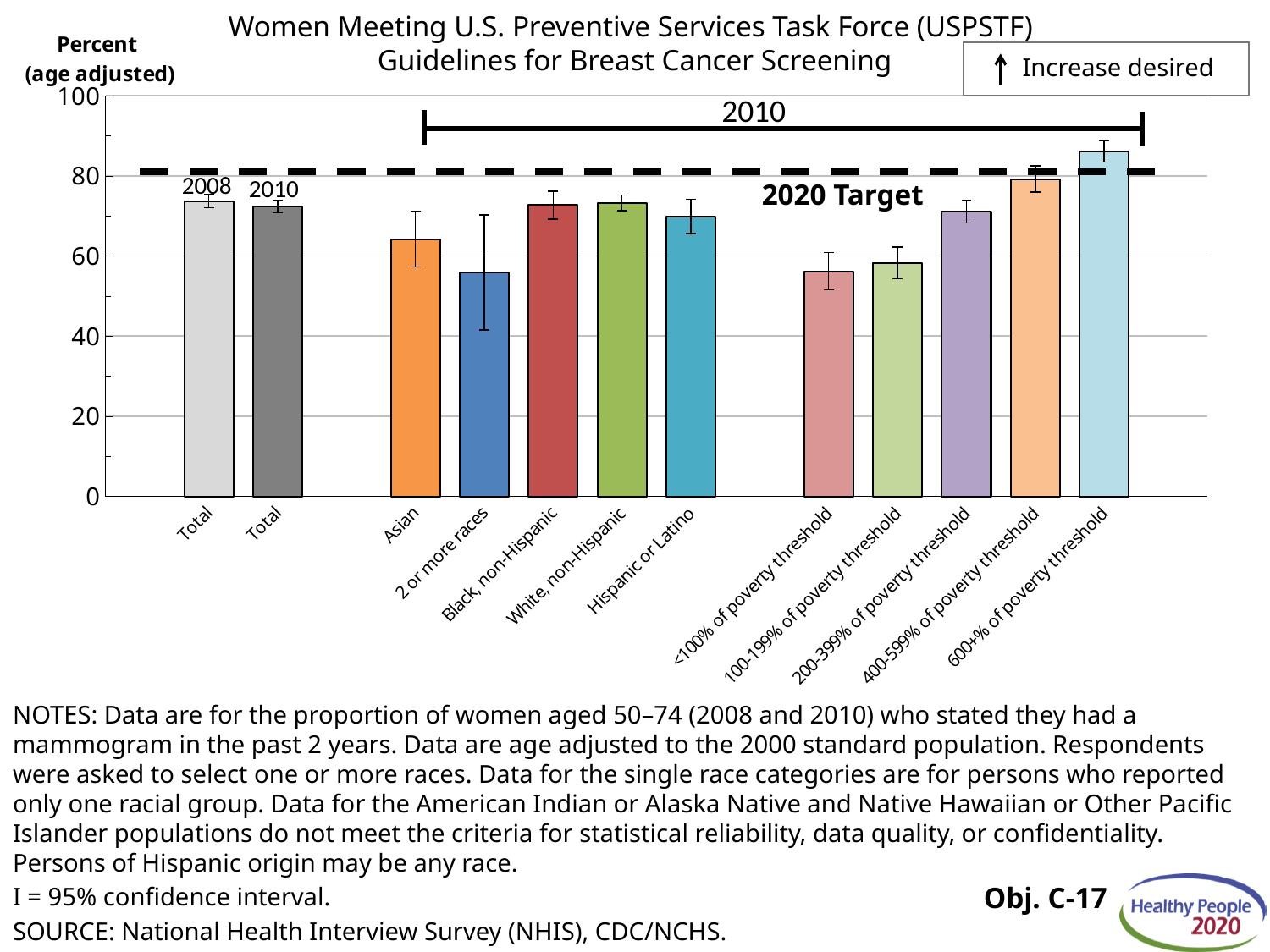
Is the value for 600+% of poverty threshold greater or less than 80? greater Is the value for Asian greater or less than 60? greater Which is larger, the value for 400-599% of poverty threshold or the value for 200-399% of poverty threshold? 400-599% of poverty threshold What is the title of the chart? Women Meeting U.S. Preventive Services Task Force (USPSTF) Guidelines for Breast Cancer Screening What does the horizontal dashed line across the chart represent? 2020 Target Is the value for 2 or more races greater or less than 60? less How many bars are plotted in the chart? 12 What kind of chart is shown on the slide? bar chart Which category has the highest value in the chart? 600+% of poverty threshold Which is larger, the value for Asian or the value for White, non-Hispanic? White, non-Hispanic